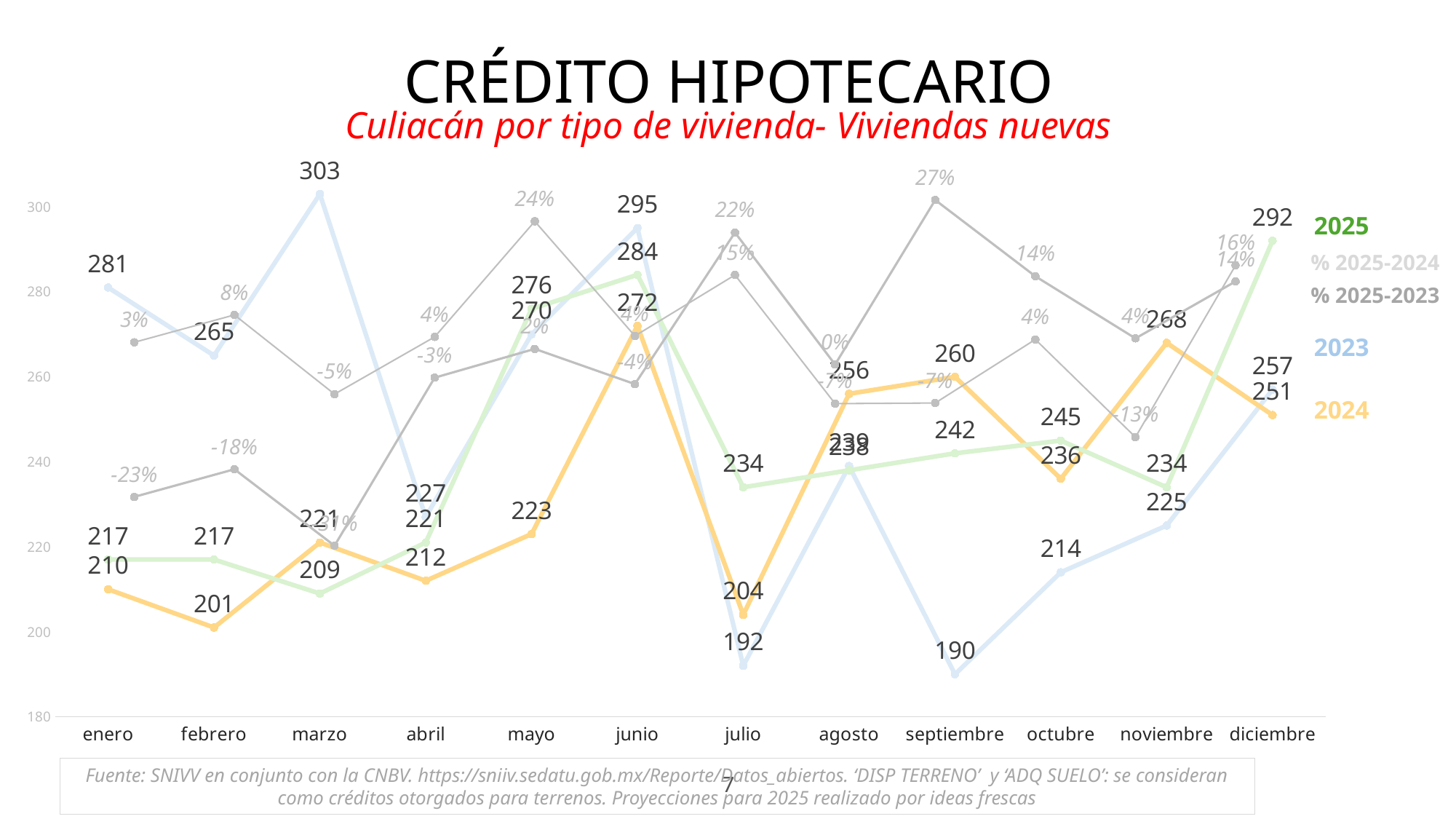
What is the red subtitle of the chart? Culiacán por tipo de vivienda- Viviendas nuevas What is the value for 2024 in junio? 272 What is the value for 2023 in marzo? 303 How many months are shown along the x axis? 12 In which month does the 2023 series reach its highest value? marzo What is the difference between the 2025 and 2024 values in diciembre? 41 How many series does the legend list? 5 What is the value for 2025 in diciembre? 292 In which month does the 2023 series reach its lowest value? septiembre What is the value for 2024 in febrero? 201 In julio, which series has the larger value, 2025 or 2024? 2025 What type of chart is shown on the slide? line chart